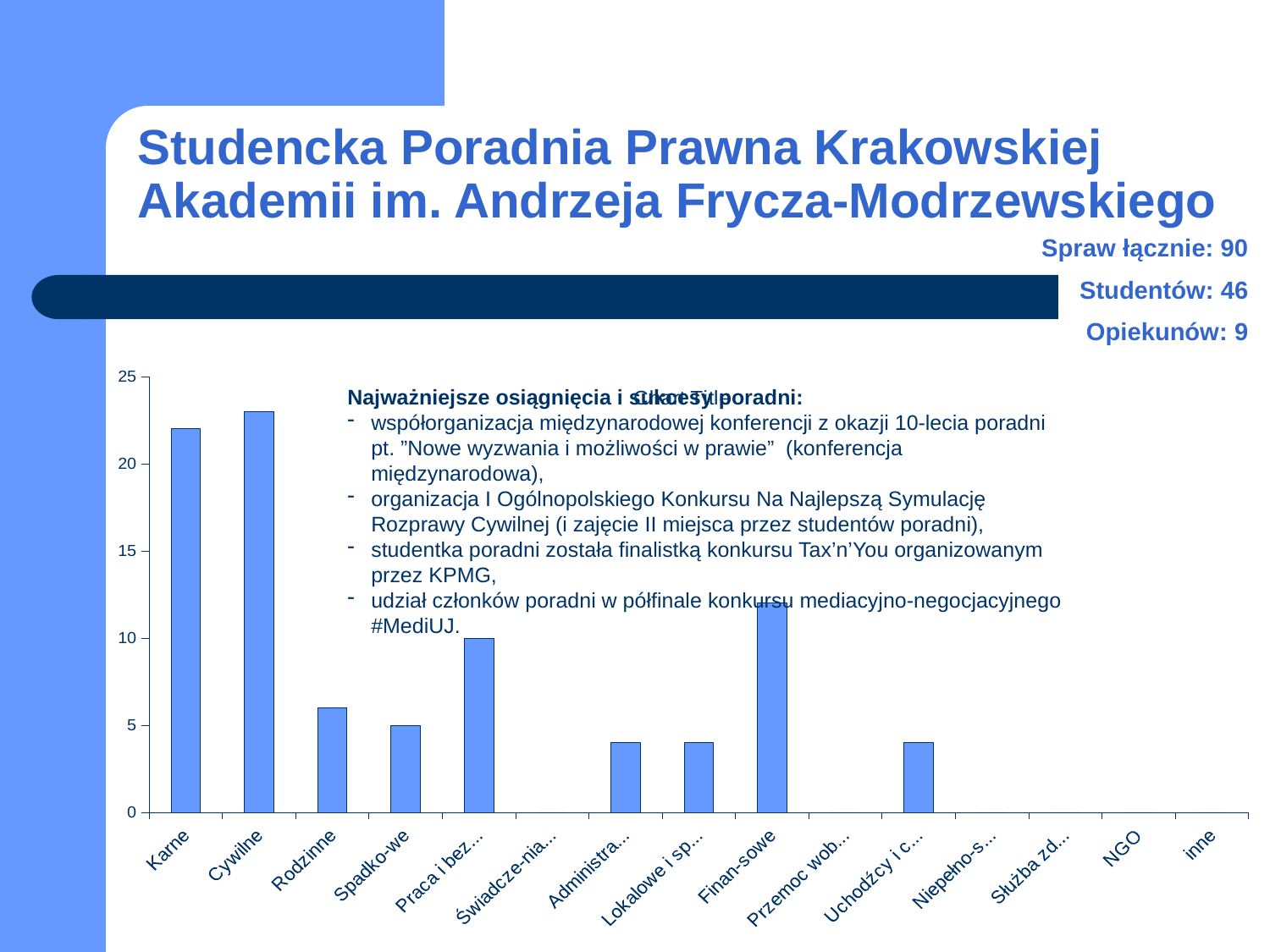
Is the value for Finan-sowe greater or less than 10? greater Is the value for Karne greater or less than 20? greater What is the value for Spadko-we? 5 What is the value for Praca i bez...? 10 Which is larger, the value for Karne or the value for Rodzinne? Karne Is the value for Administra... greater or less than 5? less Which is larger, the value for Finan-sowe or the value for Lokalowe i sp...? Finan-sowe What is the difference between the values for Praca i bez... and Spadko-we? 5 How many categories are shown on the x axis of the chart? 15 What kind of chart is shown on the slide? bar chart